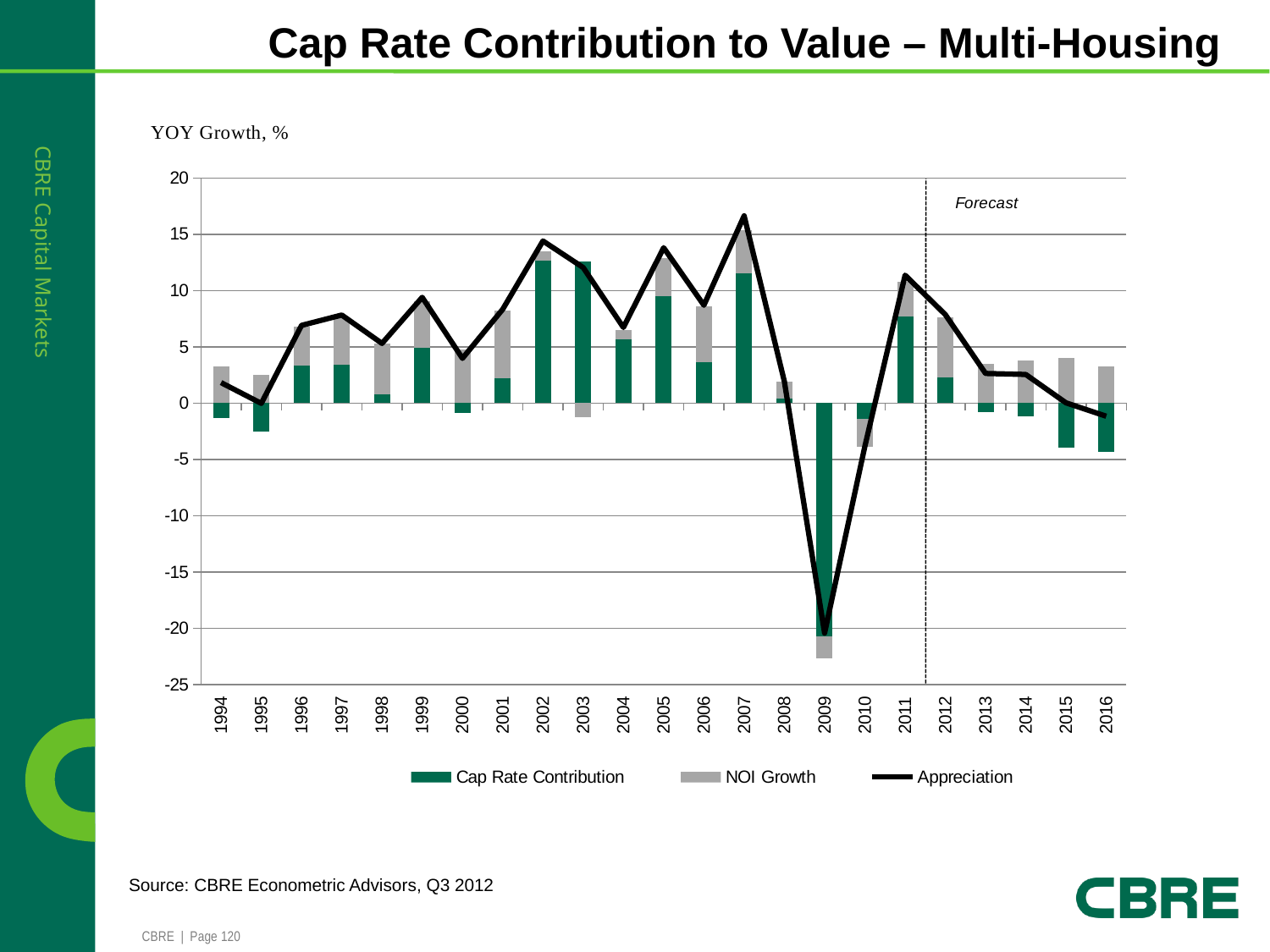
In which year is Appreciation highest? 2007 Does the Appreciation line rise or fall from 2011 to 2016? Falls Is the Appreciation value for 2009 greater or less than -15? less What kind of chart is shown on the slide? A bar chart with a line What label is shown on the chart to the right of the dashed vertical line? Forecast Is the Appreciation value for 2007 greater or less than 15? greater How many years are shown on the x axis? 23 How many series does the legend list? 3 Which year has the larger Appreciation value, 2002 or 2004? 2002 Which year has the larger Cap Rate Contribution, 2005 or 2006? 2005 In which year is Appreciation lowest? 2009 Is the Cap Rate Contribution value for 2002 greater or less than 10? greater